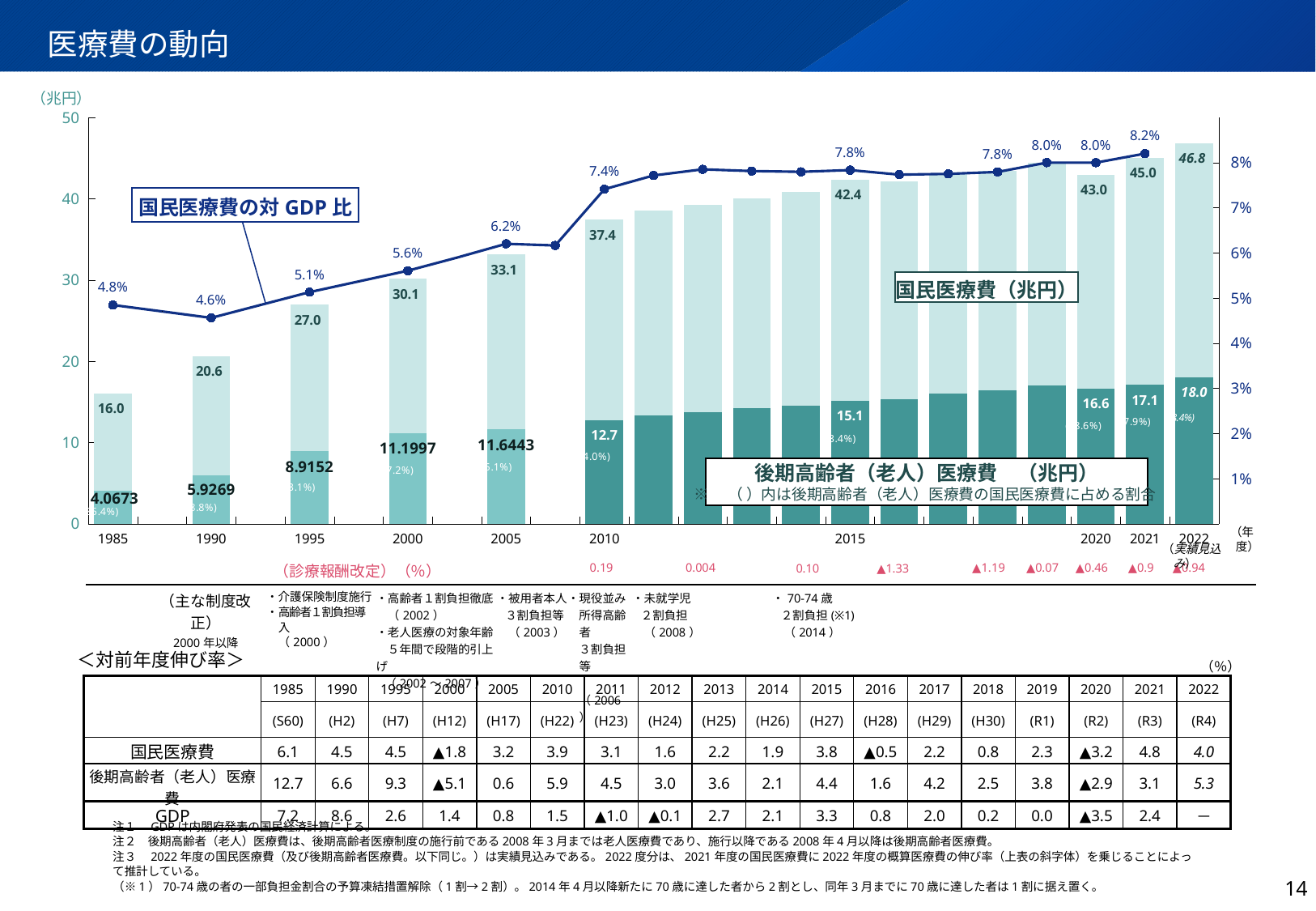
Which is larger, the ratio to GDP in 1985 or in 1990? 1985 Does the national medical expenditure generally rise or fall from 1985 to 2022? rise What is the national medical expenditure (国民医療費) shown for 2010, in trillion yen? 37.4 What is the difference between the national medical expenditure in 2021 and in 2020, in trillion yen? 2.0 What is the unit shown on the left vertical axis of the chart? 兆円 What is the late-elderly (老人) medical expenditure shown for 2021, in trillion yen? 17.1 What is the ratio of national medical expenditure to GDP shown for 1985? 4.8% What kind of chart is used to show the national medical expenditure and the late-elderly medical expenditure? bar chart In which year does the ratio of national medical expenditure to GDP reach its highest labelled value? 2021 Is the national medical expenditure for 2015 greater or less than 40 trillion yen? greater Which year has the lowest labelled national medical expenditure? 1985 What is the national medical expenditure shown for 2022 (estimated), in trillion yen? 46.8